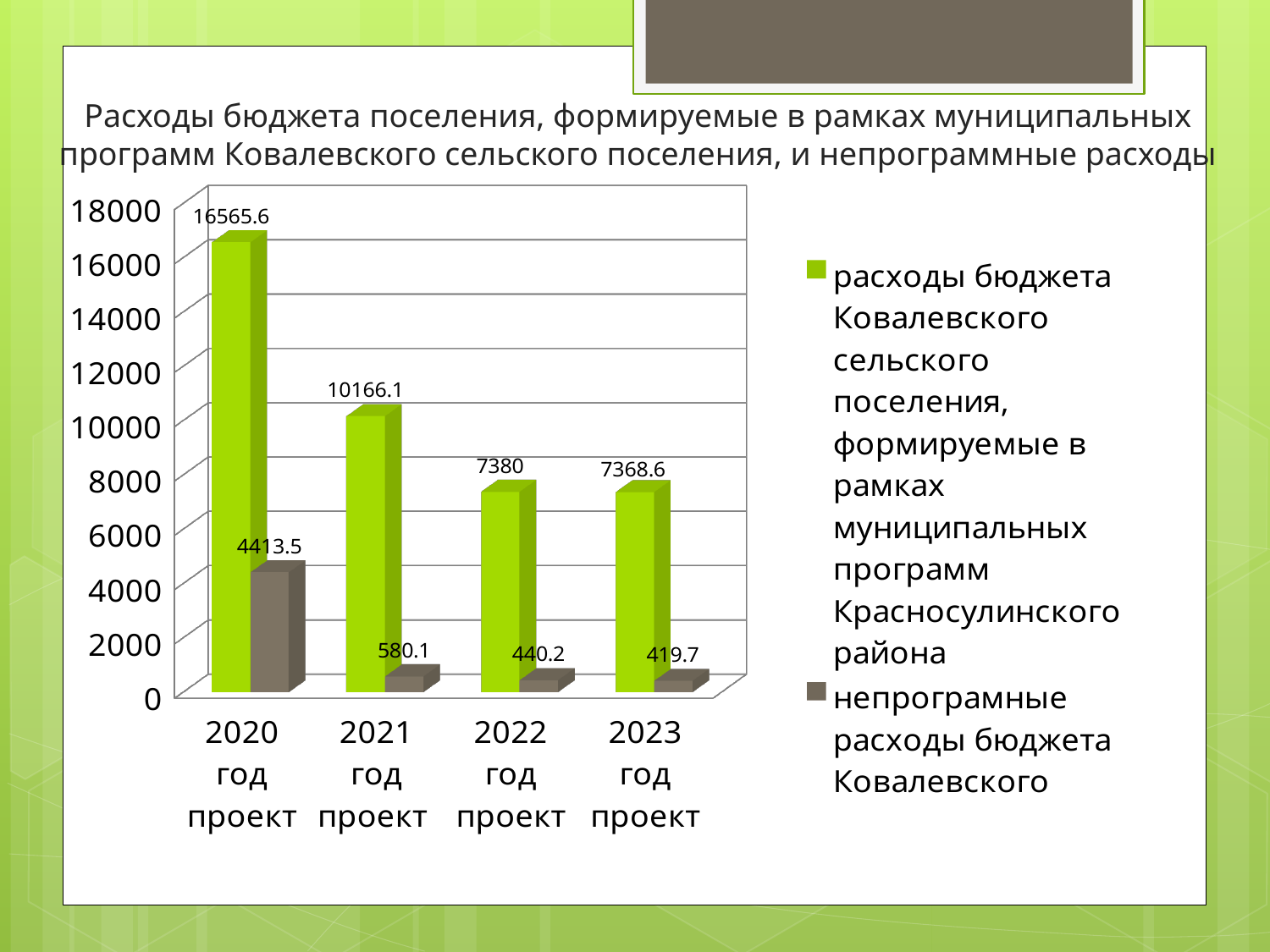
What is the value of the grey series for 2023 год проект? 419.7 What is the value of the green series (расходы бюджета, формируемые в рамках муниципальных программ) for 2020 год проект? 16565.6 What is the value of the green series for 2022 год проект? 7380 In which year is the green series (program expenses) highest? 2020 год проект Which is larger: the grey value for 2020 год проект or the grey value for 2021 год проект? 2020 год проект What kind of chart is shown on the slide? Bar chart In which year is the grey series (непрограмные расходы) lowest? 2023 год проект Is the green value for 2021 год проект greater or less than 10000? greater How many series does the legend list? 2 How many year categories are shown on the x axis? 4 What is the difference between the green and grey values for 2020 год проект? 12152.1 What is the value of the grey series (непрограмные расходы) for 2021 год проект? 580.1